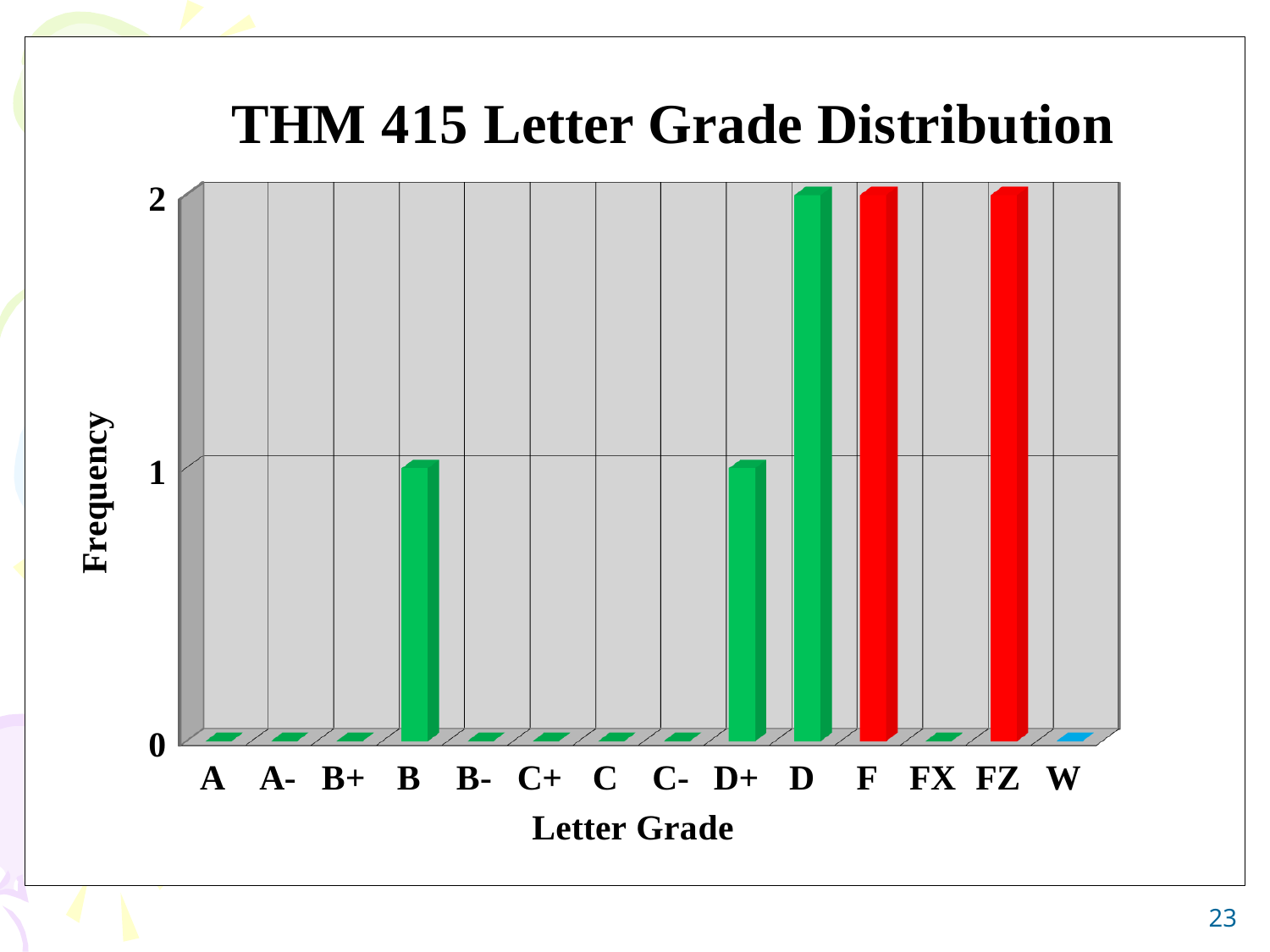
What is the label of the vertical axis? Frequency How many letter grade categories are shown on the x axis? 14 What kind of chart is shown on the slide? Bar chart Which letter grades have the highest frequency? D, F, FZ What is the frequency for letter grade FZ? 2 What is the frequency for letter grade D+? 1 What is the frequency for letter grade A? 0 What is the difference between the frequency for D and the frequency for B? 1 What is the frequency for letter grade D? 2 What is the title of the chart? THM 415 Letter Grade Distribution Which has a higher frequency, B or F? F What is the frequency for letter grade B? 1